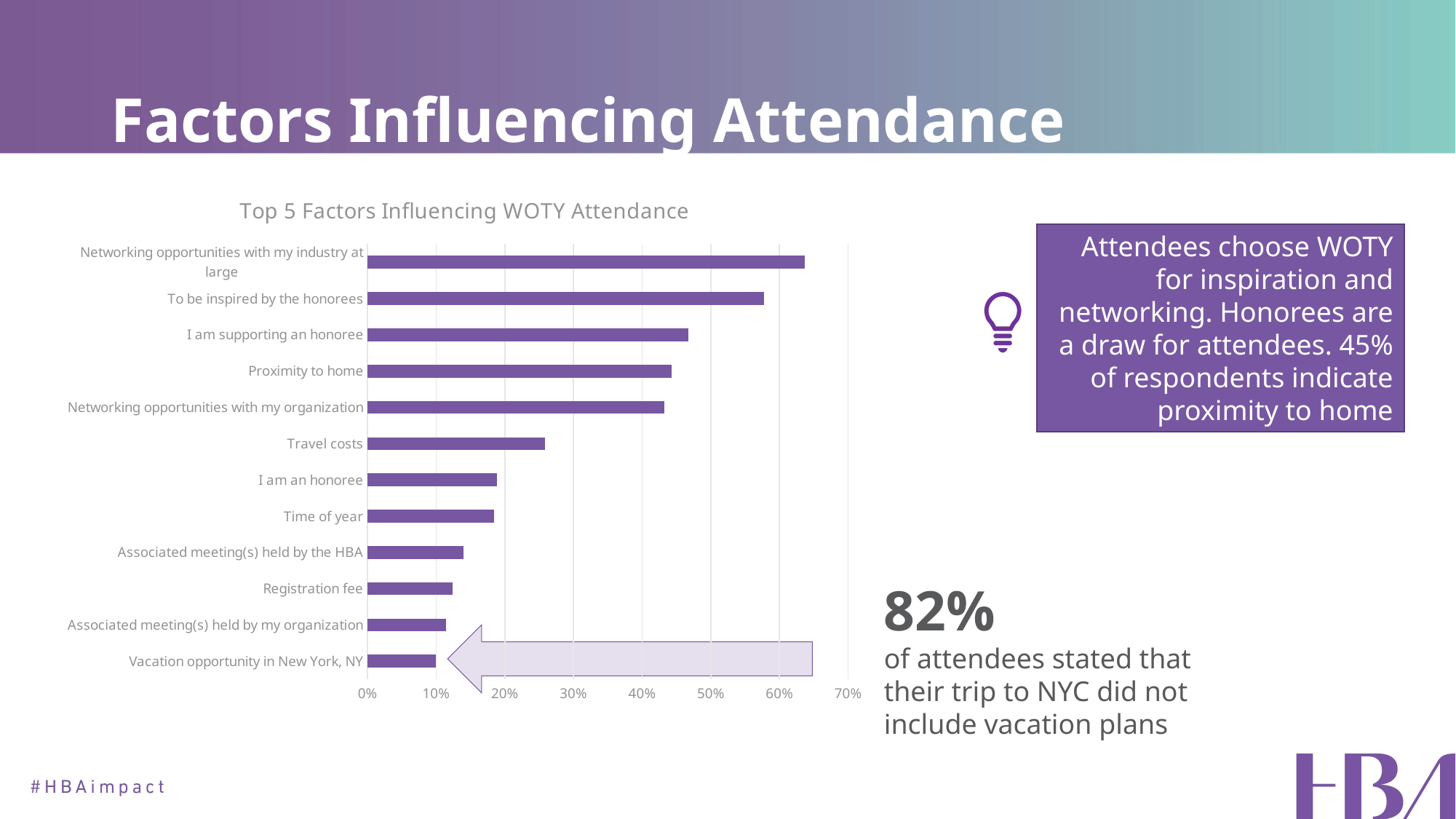
What is the title of the chart? Top 5 Factors Influencing WOTY Attendance Is the value for "To be inspired by the honorees" greater or less than 50%? greater Which factor has the lowest value in the chart? Vacation opportunity in New York, NY Is the value for "Travel costs" greater or less than 20%? greater How many factors (categories) are plotted in the chart? 12 Is the value for "I am supporting an honoree" greater or less than 50%? less Which factor has the highest value in the chart? Networking opportunities with my industry at large What kind of chart is shown on the slide? Bar chart Do the bar values increase or decrease going from the top category to the bottom category? decrease Which has a larger value: "Travel costs" or "Time of year"? Travel costs